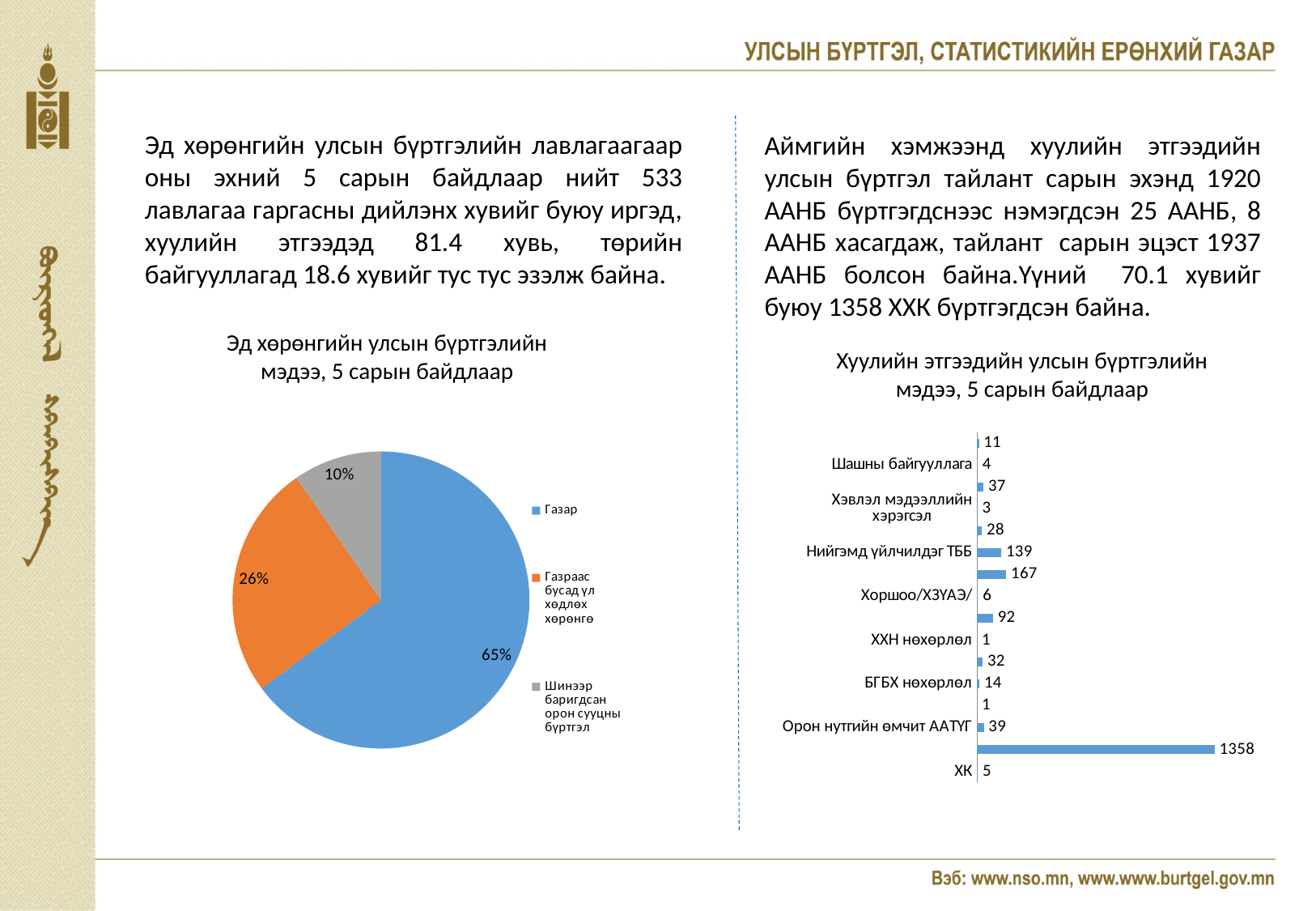
In the pie chart on the left, what share does Газраас бусад үл хөдлөх хөрөнгө have? 26% In the pie chart on the left, by how many percentage points does Газар exceed Газраас бусад үл хөдлөх хөрөнгө? 39 In the pie chart on the left, how many slices are there? 3 In the pie chart on the left, what share does Газар have? 65% In the bar chart on the right, what is the value for Орон нутгийн өмчит ААТҮГ? 39 In the pie chart on the left, which category has the smallest slice? Шинээр баригдсан орон сууцны бүртгэл What is the title of the chart on the left of the slide? Эд хөрөнгийн улсын бүртгэлийн мэдээ, 5 сарын байдлаар What type of chart is the chart on the right of the slide? Bar chart In the bar chart on the right, what is the largest value shown? 1358 In the bar chart on the right, how many bars are plotted? 16 In the pie chart on the left, which category has the largest slice? Газар In the bar chart on the right, what is the value for Нийгэмд үйлчилдэг ТББ? 139